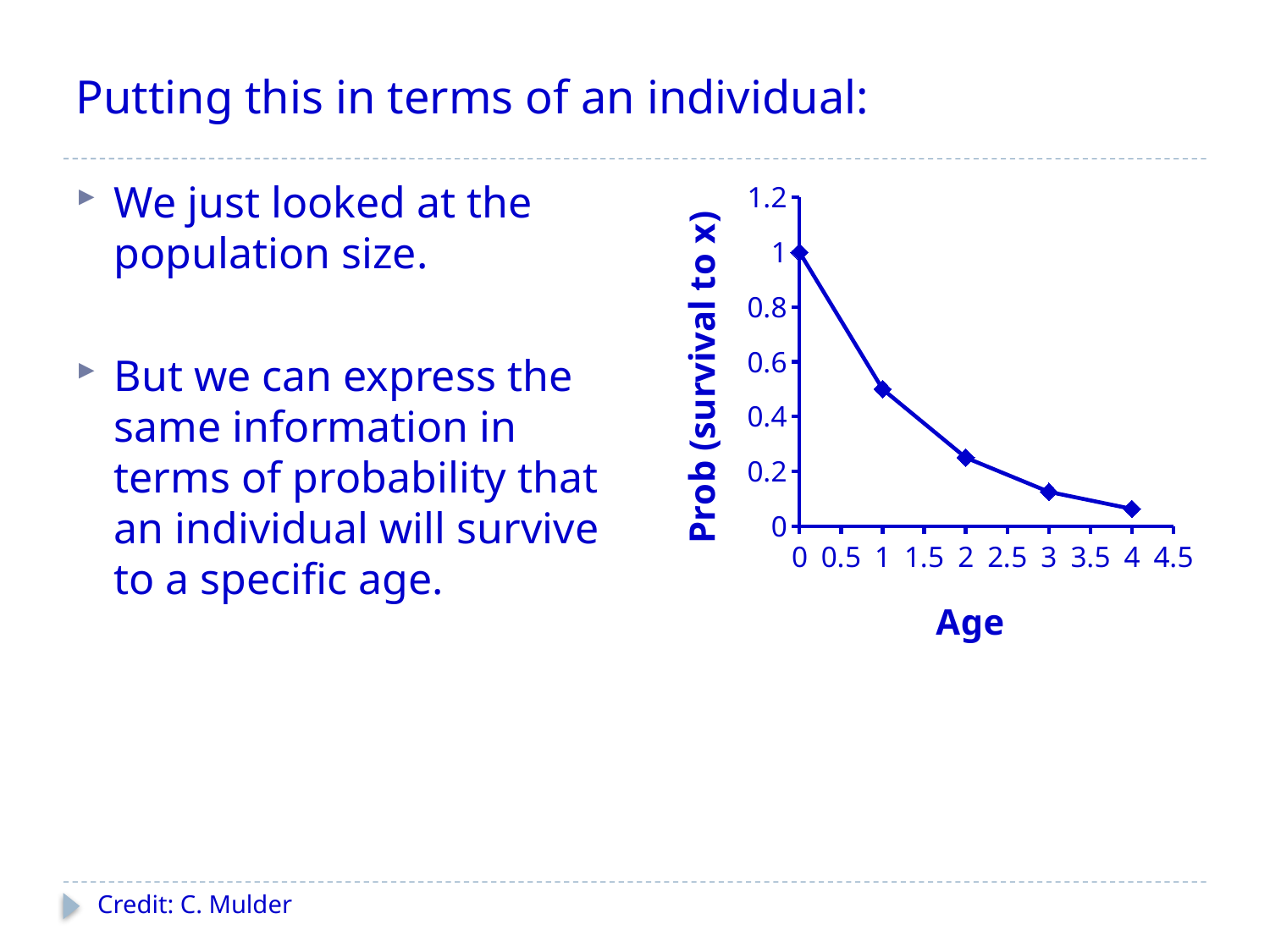
What is the title of the x axis? Age Is the value for age 2 greater or less than 0.4? less At which plotted age is the probability of survival lowest? 4 What is the title of the y axis? Prob (survival to x) Do the values rise or fall as age increases along the x axis? fall What is the probability of survival at age 0? 1 How many data points are plotted on the chart? 5 Which is larger, the value at age 1 or the value at age 3? age 1 Is the value for age 1 greater or less than 0.4? greater What kind of chart is shown on the slide? line chart At which age is the probability of survival highest? 0 Is the value for age 3 greater or less than 0.2? less